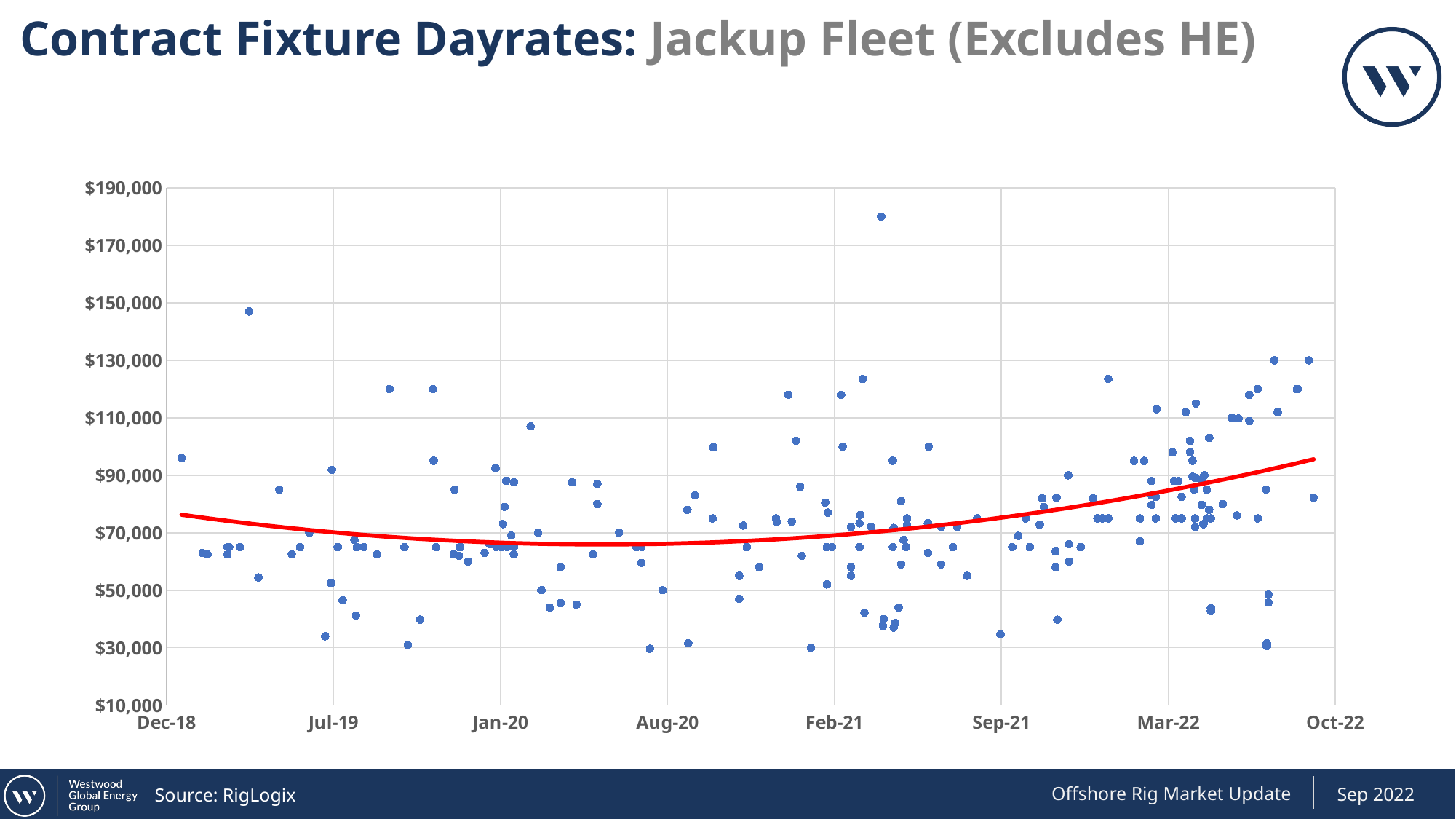
What kind of chart is shown on the slide? Scatter chart Is the highest plotted point on the chart greater or less than $170,000? greater Does the red trend line rise or fall between Sep-21 and Oct-22? Rise Are the lowest plotted points on the chart greater or less than $50,000? less How many date labels are shown along the x axis? 8 Does the red trend line end higher or lower at Oct-22 than it starts at Dec-18? Higher What colour is the trend line drawn through the scatter points? Red Is the red trend line at its left-hand end (near Dec-18) greater or less than $90,000? less What is the title of the chart on the slide? Contract Fixture Dayrates: Jackup Fleet (Excludes HE) Is the highest plotted point located before or after Feb-21 on the x axis? After